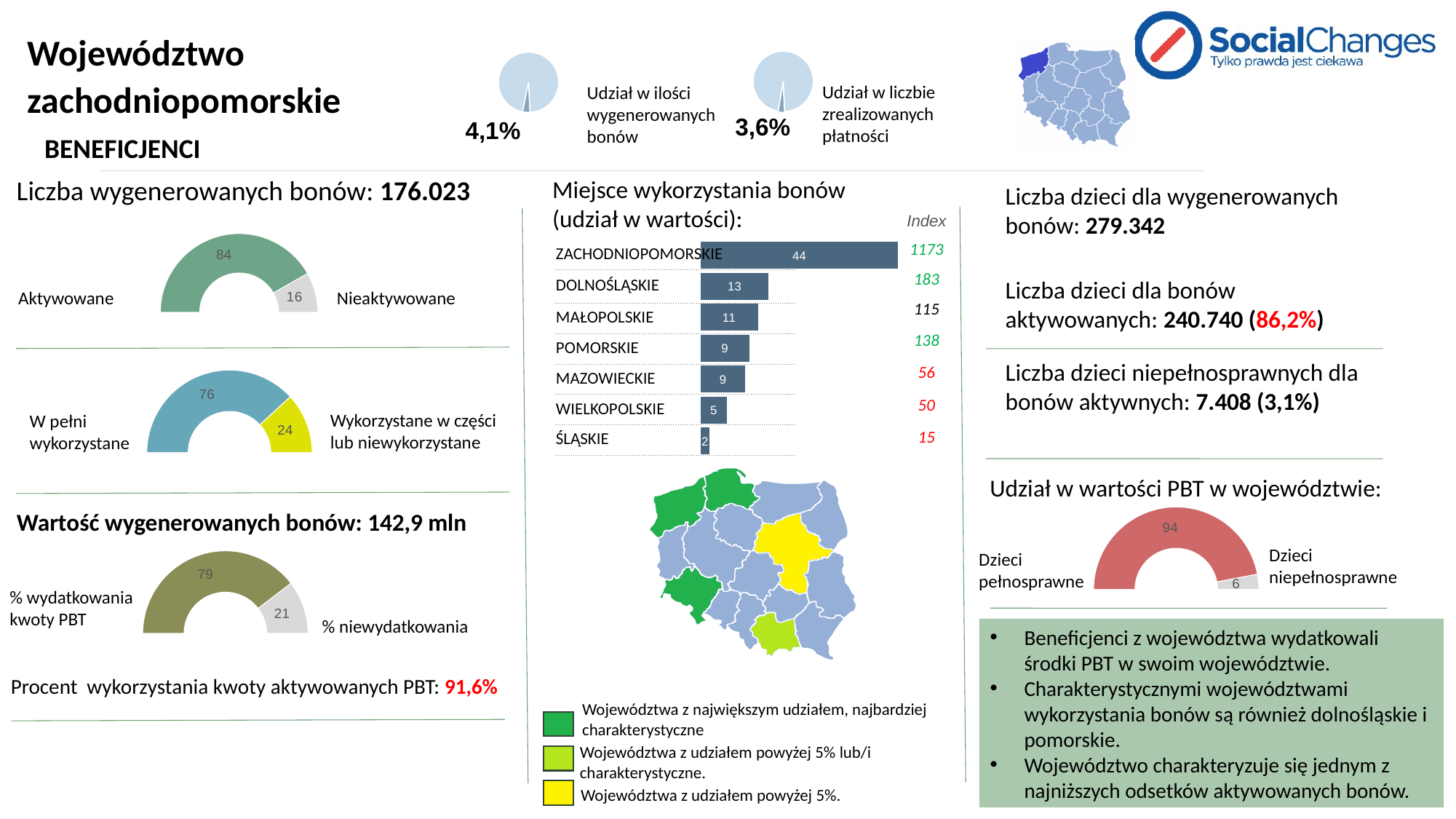
In the half-donut chart with 'W pełni wykorzystane', what is the difference between W pełni wykorzystane and Wykorzystane w części lub niewykorzystane? 52 In the bar chart 'Miejsce wykorzystania bonów (udział w wartości)', which voivodeship has the lowest value? ŚLĄSKIE In the bar chart 'Miejsce wykorzystania bonów (udział w wartości)', how many voivodeships are listed? 7 In the half-donut chart under 'Liczba wygenerowanych bonów', what is the value for Aktywowane? 84 What kind of chart is 'Miejsce wykorzystania bonów (udział w wartości)'? bar chart In the half-donut chart under 'Wartość wygenerowanych bonów', what is the value for % niewydatkowania? 21 In the half-donut chart 'Udział w wartości PBT w województwie', what is the value for Dzieci niepełnosprawne? 6 In the bar chart 'Miejsce wykorzystania bonów (udział w wartości)', which is larger: the value for MAŁOPOLSKIE or WIELKOPOLSKIE? MAŁOPOLSKIE In the bar chart 'Miejsce wykorzystania bonów (udział w wartości)', what is the value for ZACHODNIOPOMORSKIE? 44 In the bar chart 'Miejsce wykorzystania bonów (udział w wartości)', what is the Index value shown for POMORSKIE? 138 In the bar chart 'Miejsce wykorzystania bonów (udział w wartości)', what is the difference between the values for ZACHODNIOPOMORSKIE and DOLNOŚLĄSKIE? 31 In the bar chart 'Miejsce wykorzystania bonów (udział w wartości)', what is the value for DOLNOŚLĄSKIE? 13